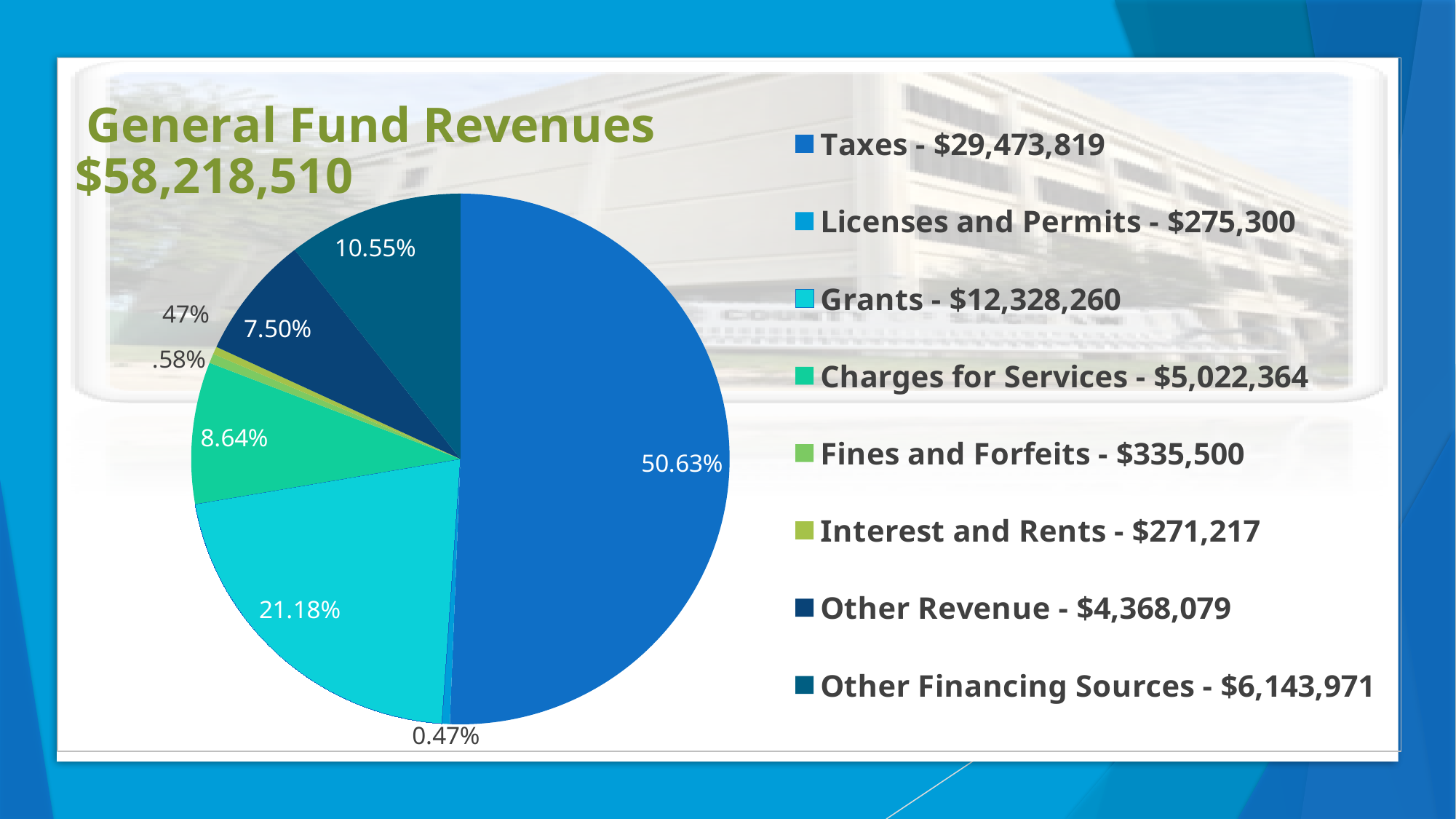
Which is larger, Other Revenue or Other Financing Sources? Other Financing Sources Which revenue category is the largest? Taxes How many revenue categories does the legend list? 8 What is the dollar amount for Charges for Services? $5,022,364 What kind of chart is shown on the slide? pie chart What is the total General Fund Revenues amount shown in the chart title? $58,218,510 Which revenue category has the smallest dollar amount in the legend? Interest and Rents What share of the pie does Other Financing Sources represent? 10.55% What share of the pie does Grants represent? 21.18% What is the dollar amount for Grants? $12,328,260 What is the dollar amount for Taxes? $29,473,819 What share of the pie does Taxes represent? 50.63%